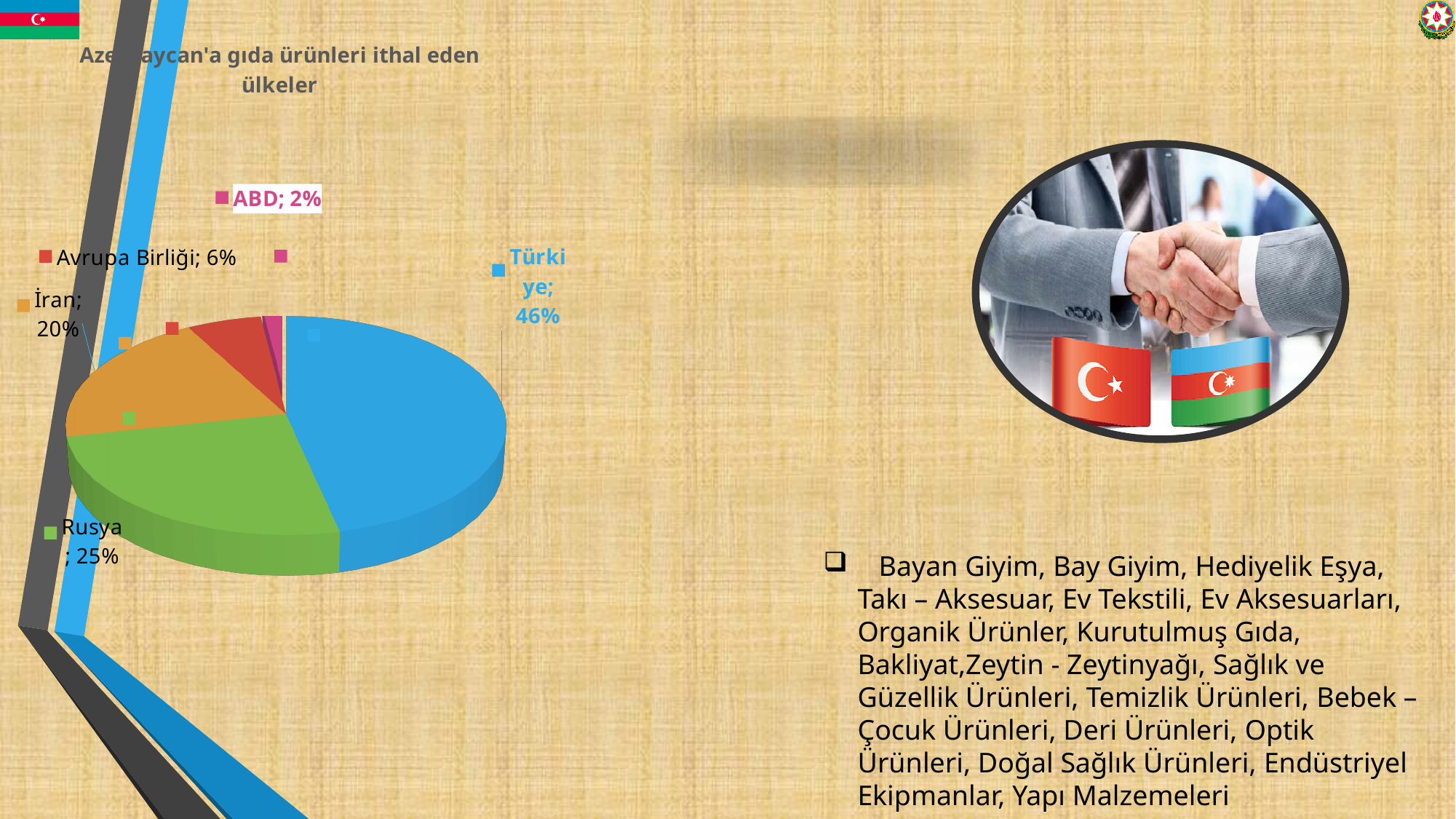
What is the title of the chart? Azerbaycan'a gıda ürünleri ithal eden ülkeler What is the value shown for Rusya? 25% Which category has the smallest slice of the pie? ABD What kind of chart is shown on the slide? Pie chart What share of the pie does Türkiye hold? 46% Which is larger, the share for İran or the share for Avrupa Birliği? İran What percentage is shown for İran? 20% What is the value shown for ABD? 2% How many categories are shown in the pie chart? 5 Which country has the largest slice of the pie? Türkiye What is the value for Avrupa Birliği? 6% What is the difference between the shares of Türkiye and Rusya? 21%